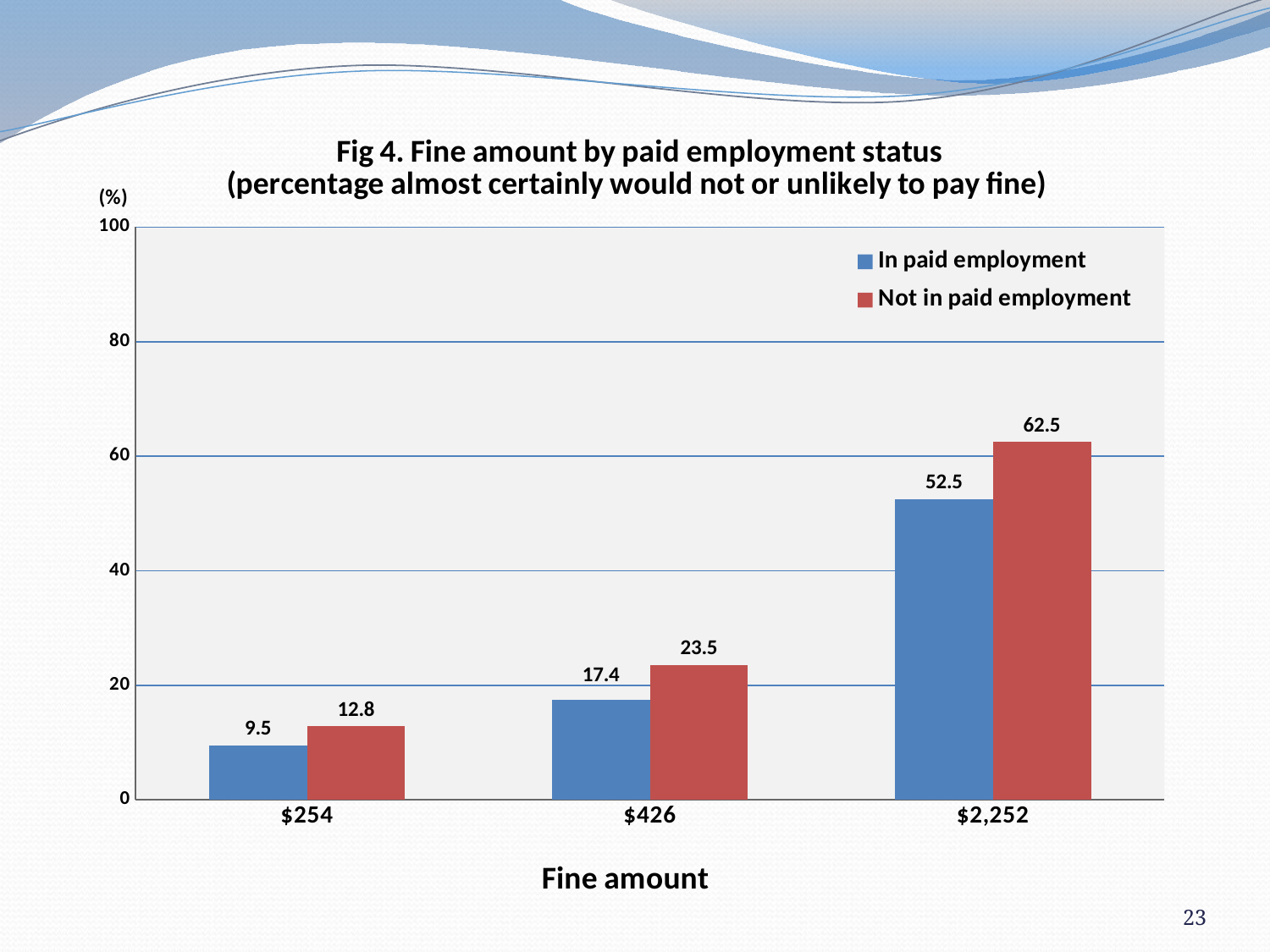
What is the value for 'Not in paid employment' at the $426 fine amount? 23.5 What is the difference between 'Not in paid employment' and 'In paid employment' at the $2,252 fine amount? 10 At the $426 fine amount, which series has the larger value: 'In paid employment' or 'Not in paid employment'? Not in paid employment What kind of chart is shown on the slide? Bar chart Which fine amount has the highest value for 'In paid employment'? $2,252 Is the value for 'In paid employment' at $2,252 greater or less than 40? greater Do the values for 'Not in paid employment' rise or fall as the fine amount increases along the x axis? Rise What is the value for 'In paid employment' at the $254 fine amount? 9.5 How many fine amount categories are shown on the x axis? 3 Which fine amount has the lowest value for 'Not in paid employment'? $254 How many series does the legend list? 2 What is the value for 'Not in paid employment' at the $2,252 fine amount? 62.5